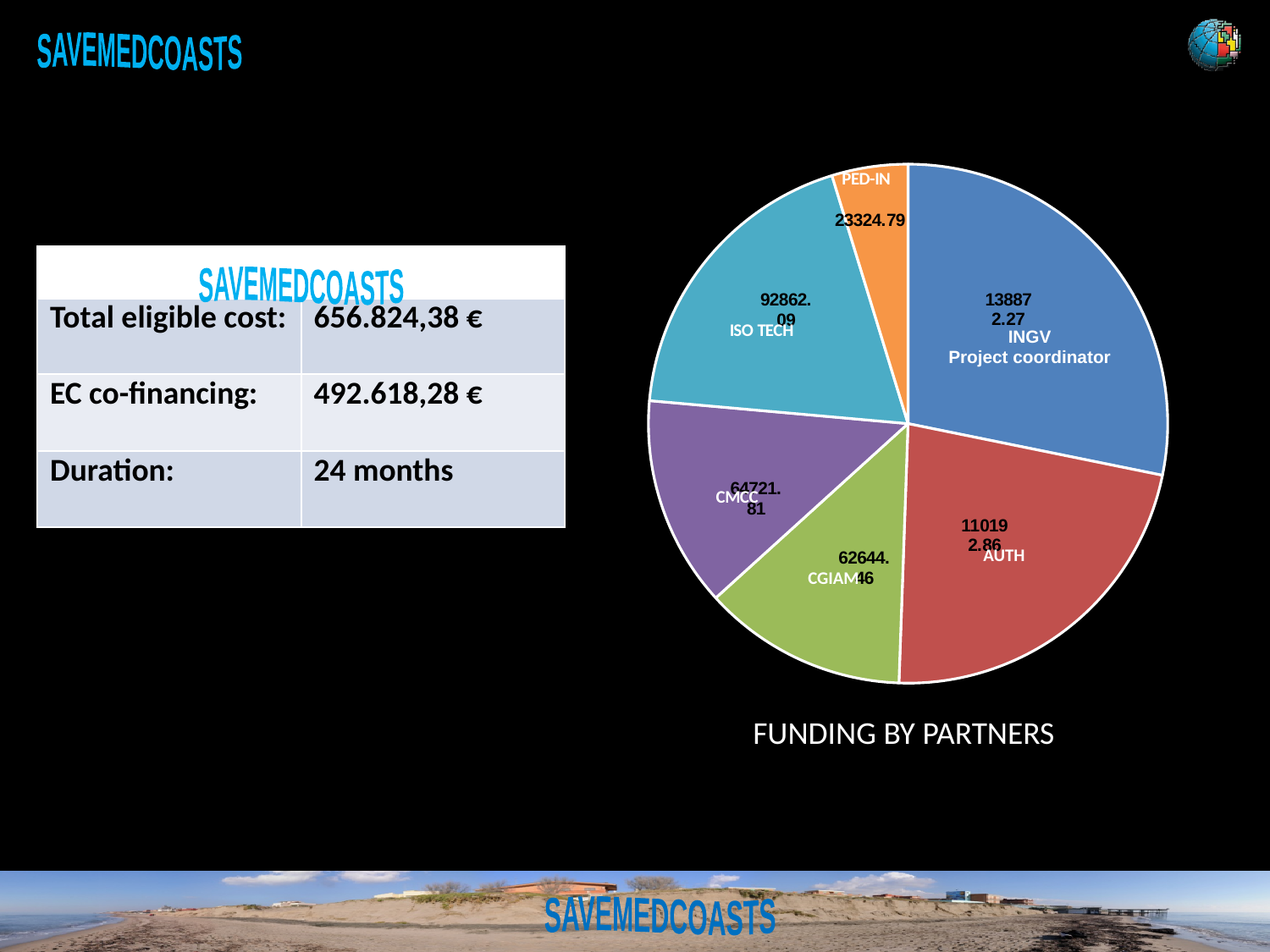
How many partners (slices) are shown in the pie chart? 6 What is the title of the chart? FUNDING BY PARTNERS What is the difference between the funding values of ISO TECH and PED-IN? 69537.30 What is the funding value for AUTH? 110192.86 What colour is the AUTH slice in the pie chart? red What is the funding value for ISO TECH? 92862.09 What is the funding value for PED-IN? 23324.79 What type of chart is shown on the slide? pie chart Which partner has the larger funding value, CMCC or CGIAM? CMCC Which partner receives the largest share of funding? INGV (Project coordinator) Which partner receives the smallest share of funding? PED-IN What is the funding value for INGV (Project coordinator)? 138872.27